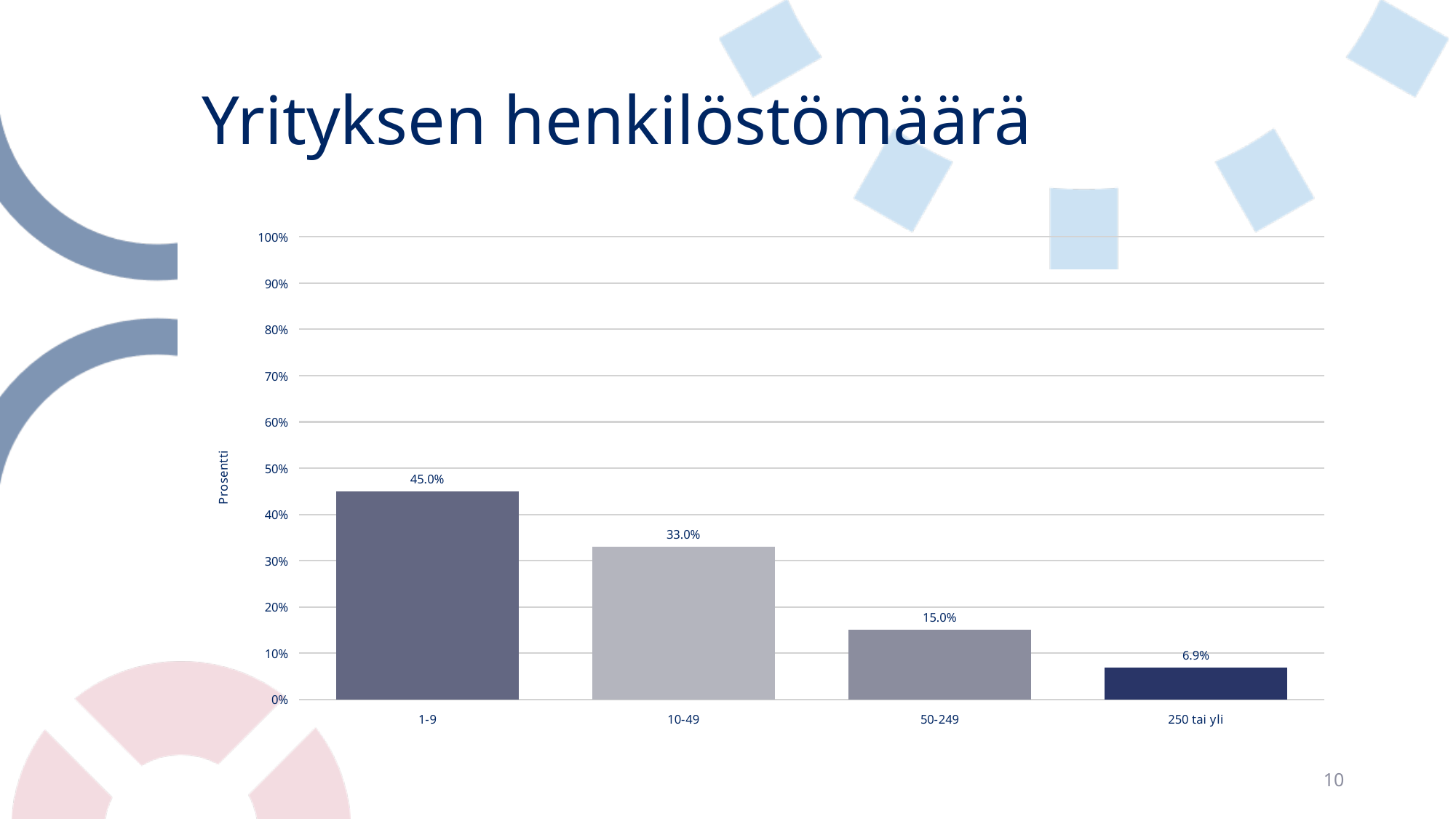
Is the value for 10-49 greater or less than 30%? greater Which category has the lowest value? 250 tai yli What is the value for the 50-249 category? 15.0% What is the value for the 1-9 category? 45.0% Which category has the highest value? 1-9 What is the difference between the values for 1-9 and 10-49? 12.0% Which is larger, the value for 50-249 or the value for 250 tai yli? 50-249 What is the value for the 10-49 category? 33.0% What is the title of the slide? Yrityksen henkilöstömäärä How many categories are shown on the x axis? 4 What kind of chart is shown on the slide? bar chart What is the value for the 250 tai yli category? 6.9%